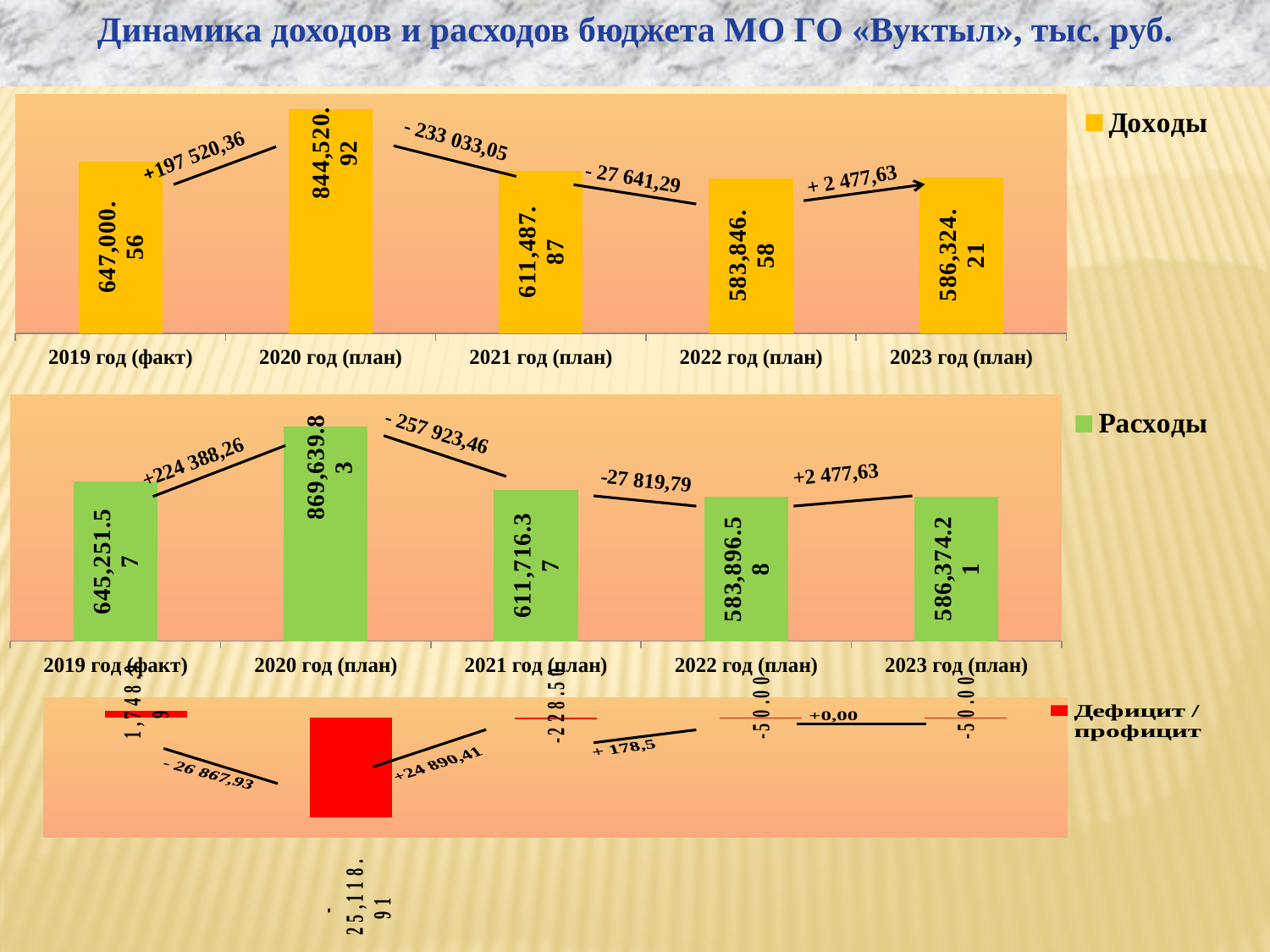
How many year categories does the Доходы chart show? 5 In the Доходы chart, which is larger: the value for 2019 год (факт) or 2021 год (план)? 2019 год (факт) In the Расходы chart, what is the value for 2022 год (план)? 583,896.58 In the Доходы chart, which year has the highest value? 2020 год (план) In the Расходы chart, what is the value for 2023 год (план)? 586,374.21 What type of chart is the Расходы chart? Bar chart In the Доходы chart, what is the value for 2019 год (факт)? 647,000.56 In the Доходы chart, what change is annotated between 2019 год (факт) and 2020 год (план)? +197 520,36 In the Расходы chart, which year has the lowest value? 2022 год (план) In the Расходы chart, what change is annotated between 2020 год (план) and 2021 год (план)? - 257 923,46 In the Доходы chart, what is the value for 2020 год (план)? 844,520.92 In the Дефицит / профицит chart, what is the value for 2020 год (план)? -25,118.91